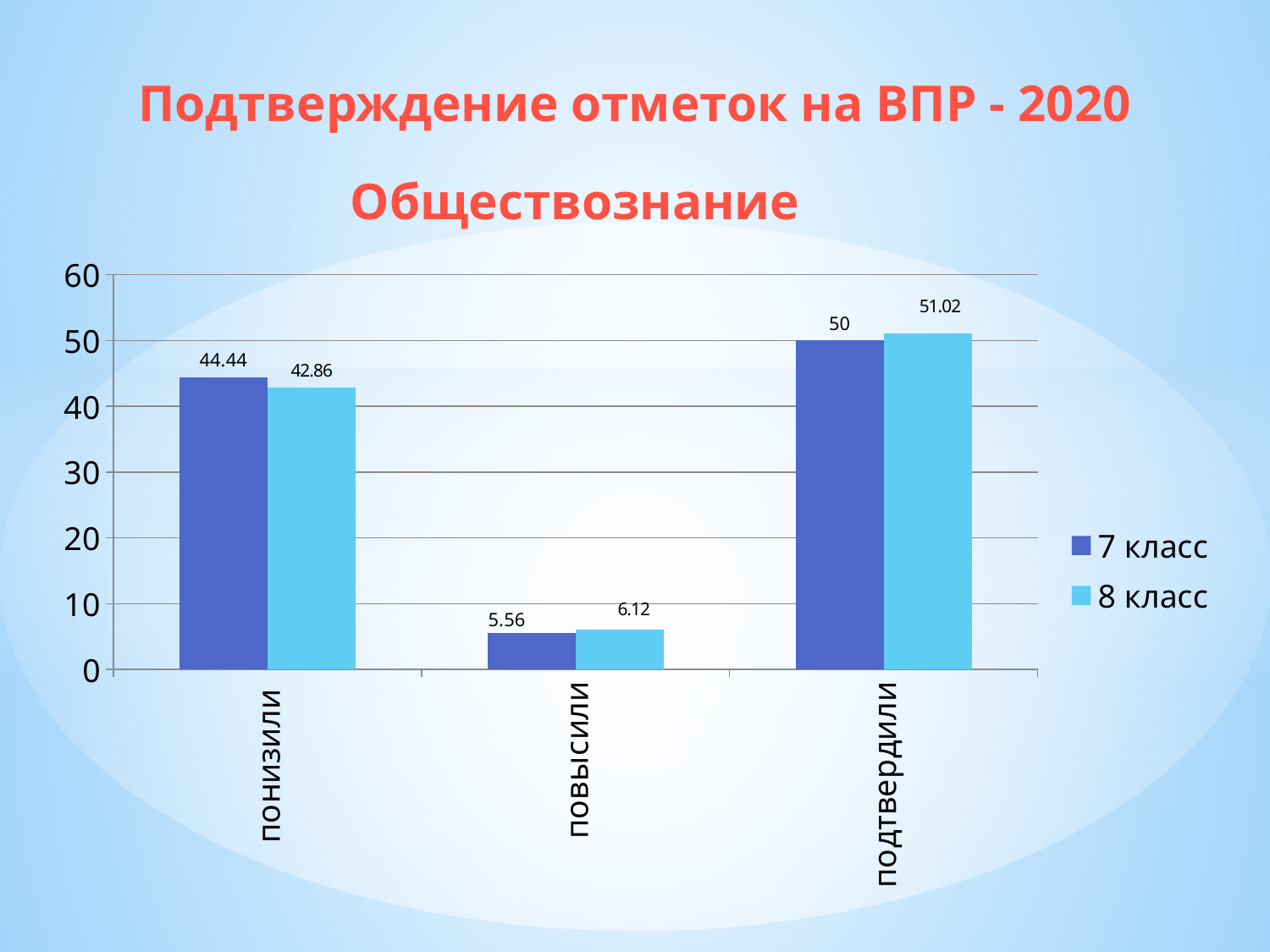
Is the value for 7 класс in the понизили category greater or less than 40? greater What is the value for 8 класс in the подтвердили category? 51.02 Which is larger in the повысили category: 7 класс or 8 класс? 8 класс How many series does the legend list? 2 What is the difference between the 8 класс and 7 класс values in the подтвердили category? 1.02 Which category has the highest value for 7 класс? подтвердили What is the value for 8 класс in the повысили category? 6.12 How many categories are shown on the x axis? 3 Which category has the lowest value for 8 класс? повысили What is the difference between the 7 класс and 8 класс values in the понизили category? 1.58 What kind of chart is shown on the slide? bar chart What is the value for 7 класс in the понизили category? 44.44